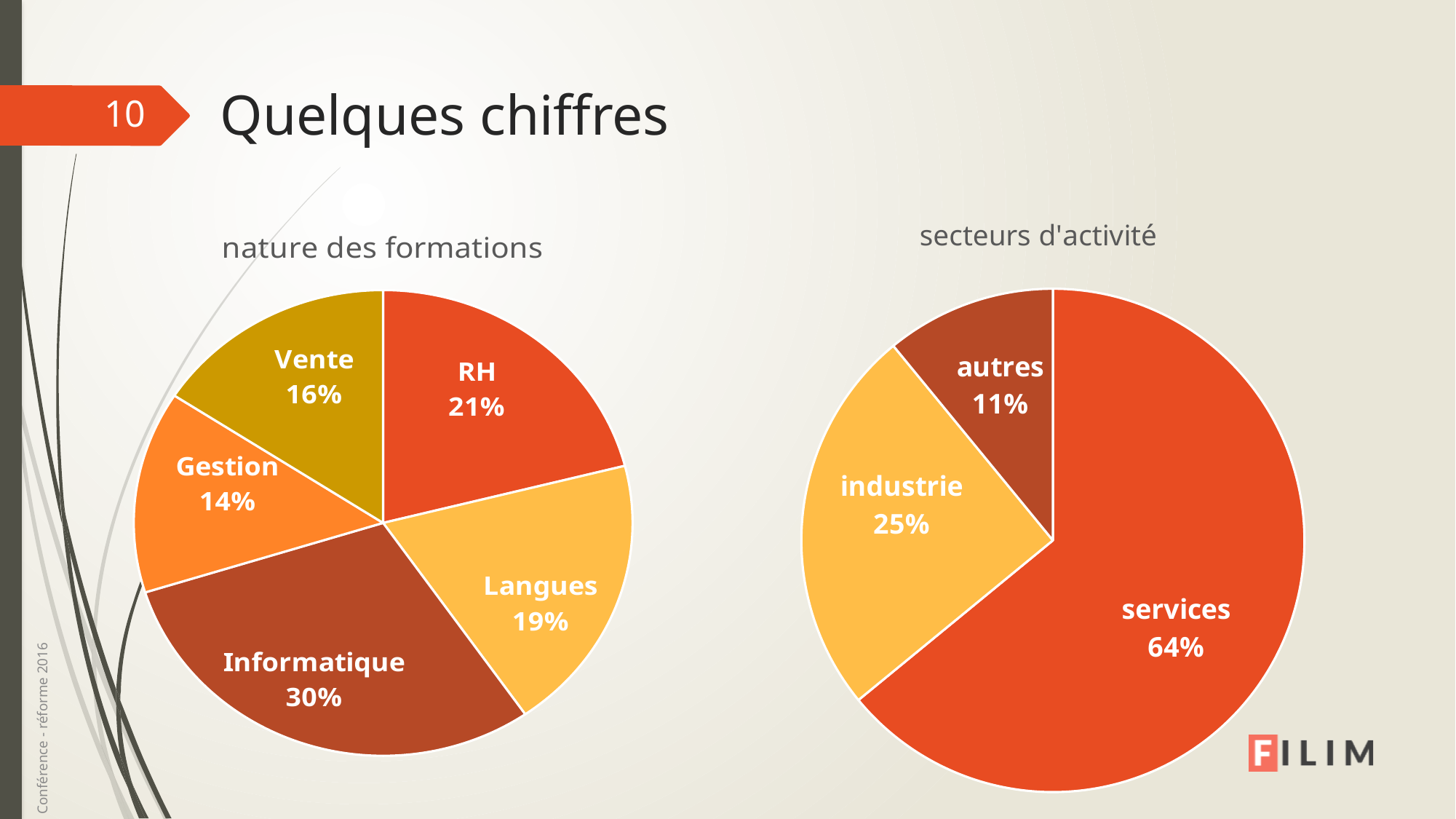
In the 'nature des formations' chart, what is the value for Gestion? 14% How many categories are shown in the 'nature des formations' chart? 5 In the 'nature des formations' chart, which category has the smallest slice? Gestion In the 'secteurs d'activité' chart, what is the difference between services and autres? 53% In the 'secteurs d'activité' chart, which sector has the largest share? services In the 'secteurs d'activité' chart, what share does industrie have? 25% How many categories are shown in the 'secteurs d'activité' chart? 3 In the 'nature des formations' chart, what share does Informatique have? 30% What type of chart is the 'secteurs d'activité' chart? Pie chart In the 'nature des formations' chart, which is larger, Vente or Gestion? Vente In the 'nature des formations' chart, what is the difference between RH and Langues? 2% In the 'nature des formations' chart, which category has the largest slice? Informatique